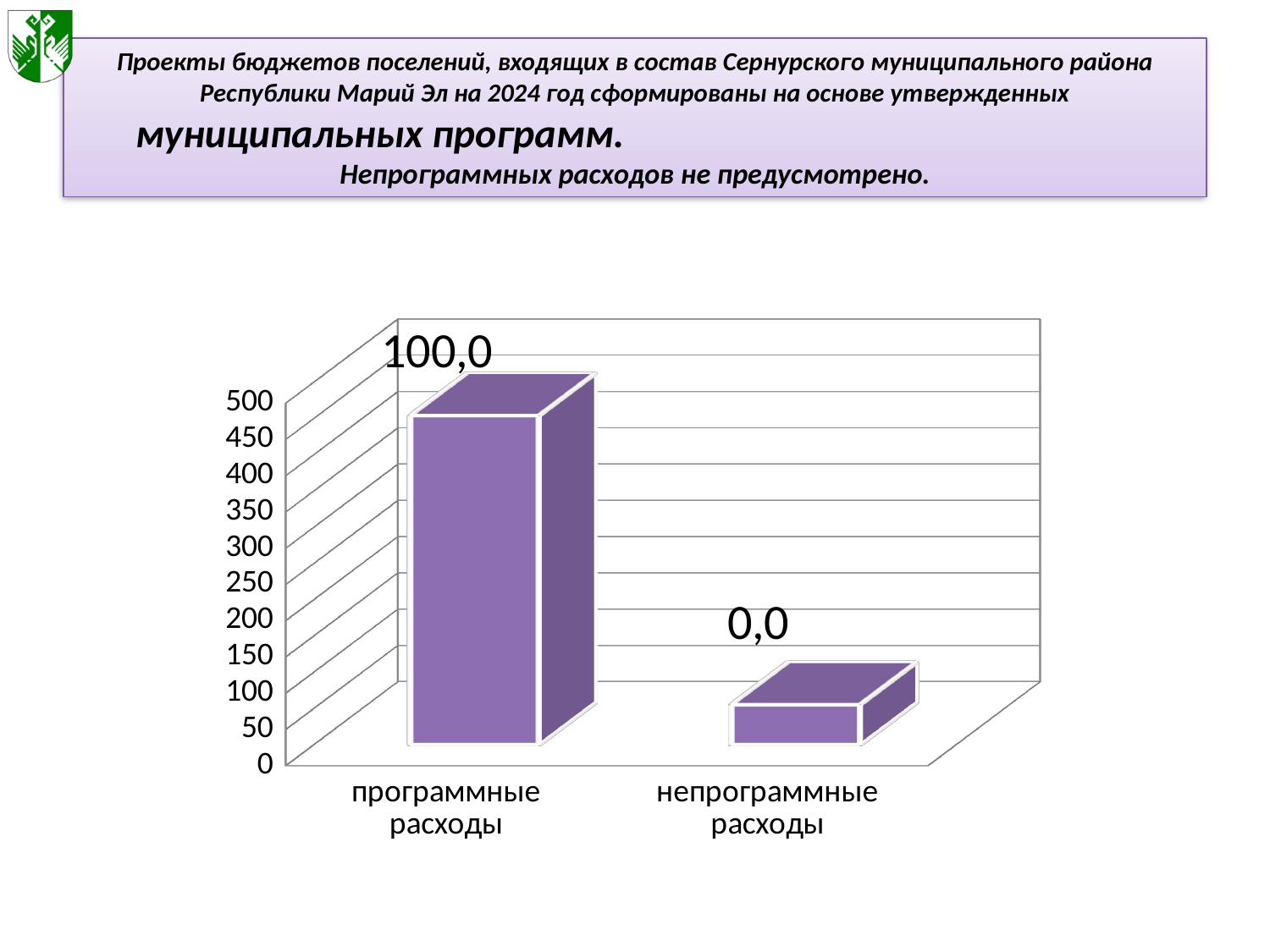
Which is larger: the value for программные расходы or the value for непрограммные расходы? программные расходы Which category has the highest value? программные расходы Do the values rise or fall from left to right along the x axis? fall What is the value shown for непрограммные расходы? 0,0 What is the highest tick value shown on the vertical axis of the chart? 500 How many categories are shown on the x axis of the chart? 2 What kind of chart is shown on the slide? bar chart Which category has the lowest value? непрограммные расходы What is the value shown for программные расходы? 100,0 What colour are the bars in the chart? purple